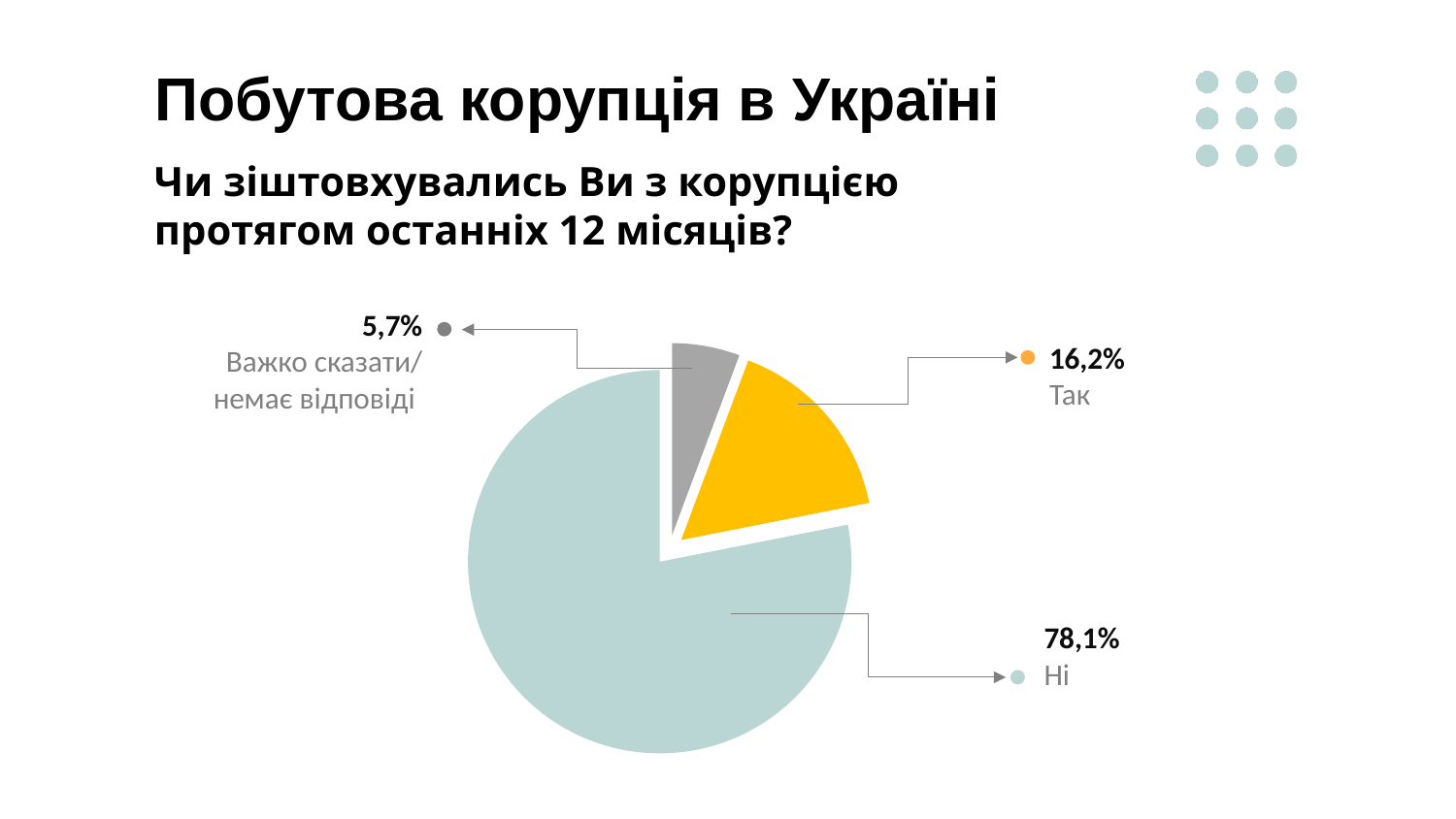
Which answer has the smallest share of the pie? Важко сказати/немає відповіді How many slices does the pie chart have? 3 Which is larger: the share for "Так" or the share for "Важко сказати/немає відповіді"? Так What question does the chart answer, according to the subtitle? Чи зіштовхувались Ви з корупцією протягом останніх 12 місяців? What colour is the slice for "Так"? yellow What share of respondents answered "Ні"? 78,1% What share of respondents answered "Так"? 16,2% What is the difference in percentage points between "Так" and "Важко сказати/немає відповіді"? 10,5 What is the difference in percentage points between "Ні" and "Так"? 61,9 What share of respondents answered "Важко сказати/немає відповіді"? 5,7% Which answer has the largest share of the pie? Ні What kind of chart is shown on the slide? pie chart